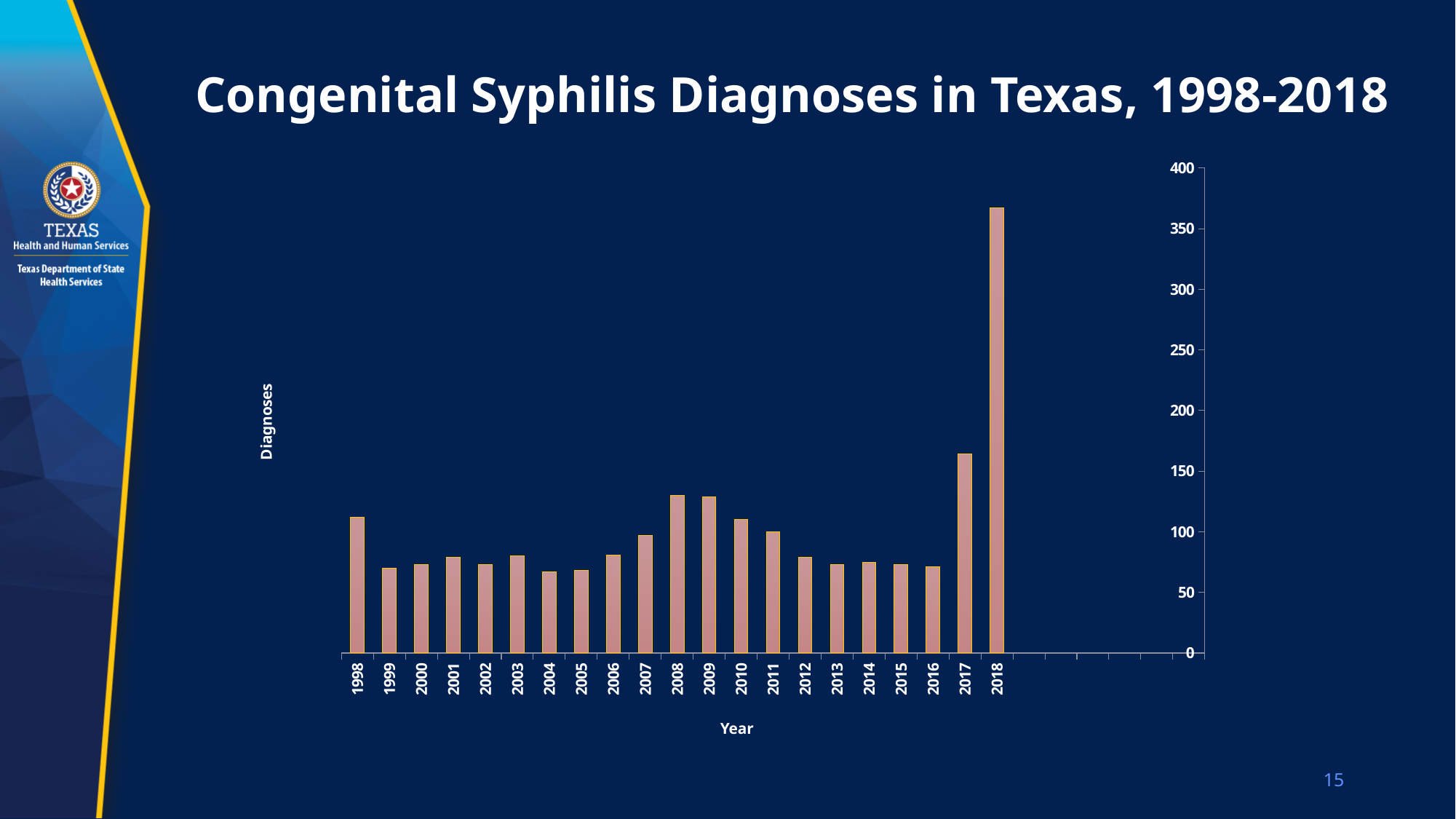
Which year has the larger value, 2017 or 2018? 2018 What kind of chart is shown on the slide? bar chart Do the values rise or fall from 2008 to 2012? fall Which year has the highest number of congenital syphilis diagnoses? 2018 Is the value for 2012 greater or less than 100? less Is the value for 1999 greater or less than 50? greater How many years are plotted on the x axis of the chart? 21 Which year has the larger value, 1998 or 1999? 1998 Is the value for 2018 greater or less than 350? greater What is the label on the vertical axis of the chart? Diagnoses